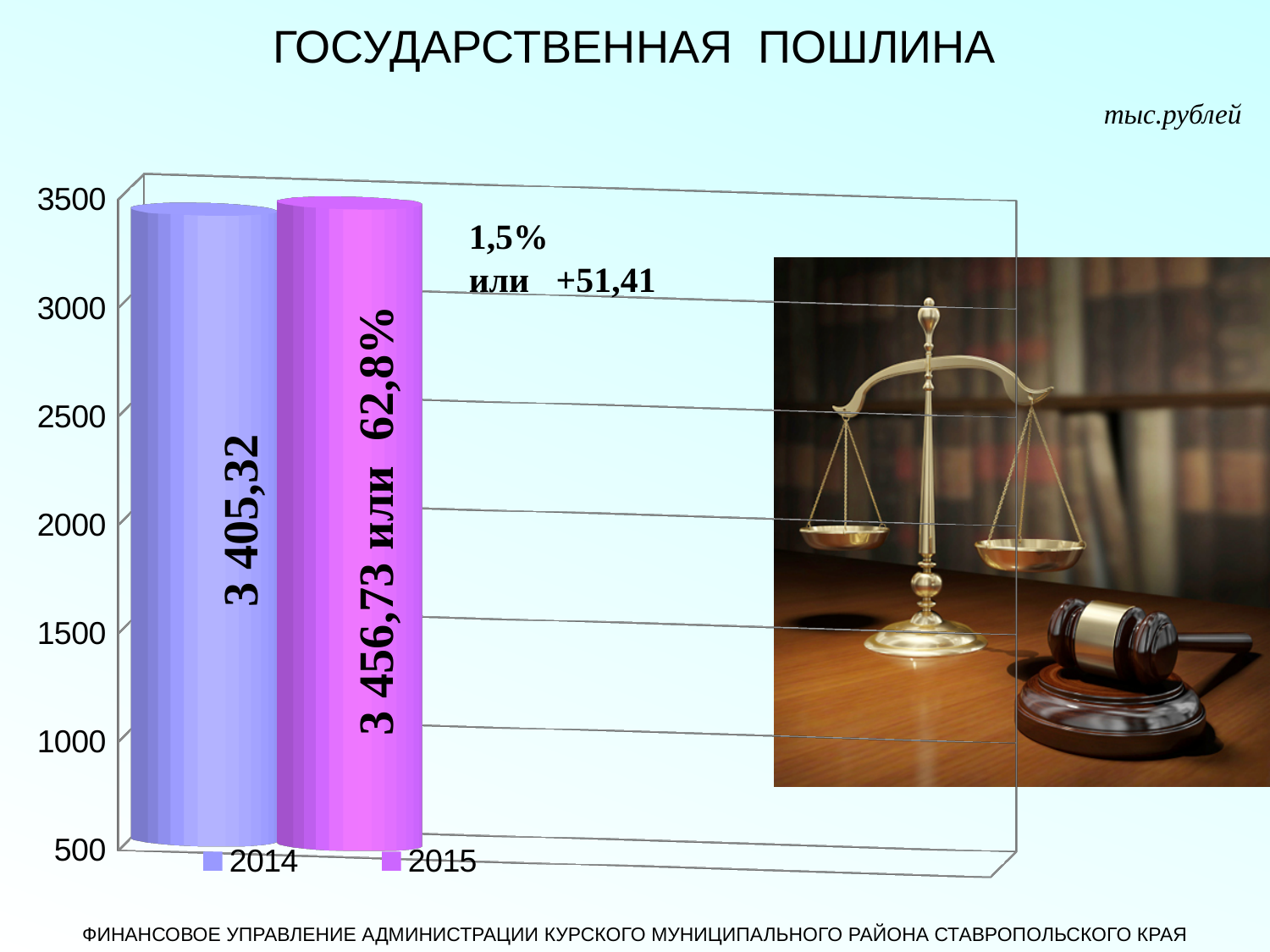
What is the title of the chart? ГОСУДАРСТВЕННАЯ ПОШЛИНА Is the value for 2014 greater or less than 3000? greater What unit of measurement is stated on the slide? тыс.рублей How many series does the legend list? 2 What is the value for 2014? 3 405,32 Which year has the higher value, 2014 or 2015? 2015 Which series has the highest value? 2015 Which series has the lowest value? 2014 What is the difference between the 2015 and 2014 values? 51,41 Do the values rise or fall from 2014 to 2015? rise What kind of chart is shown on the slide? bar chart What is the value for 2015? 3 456,73